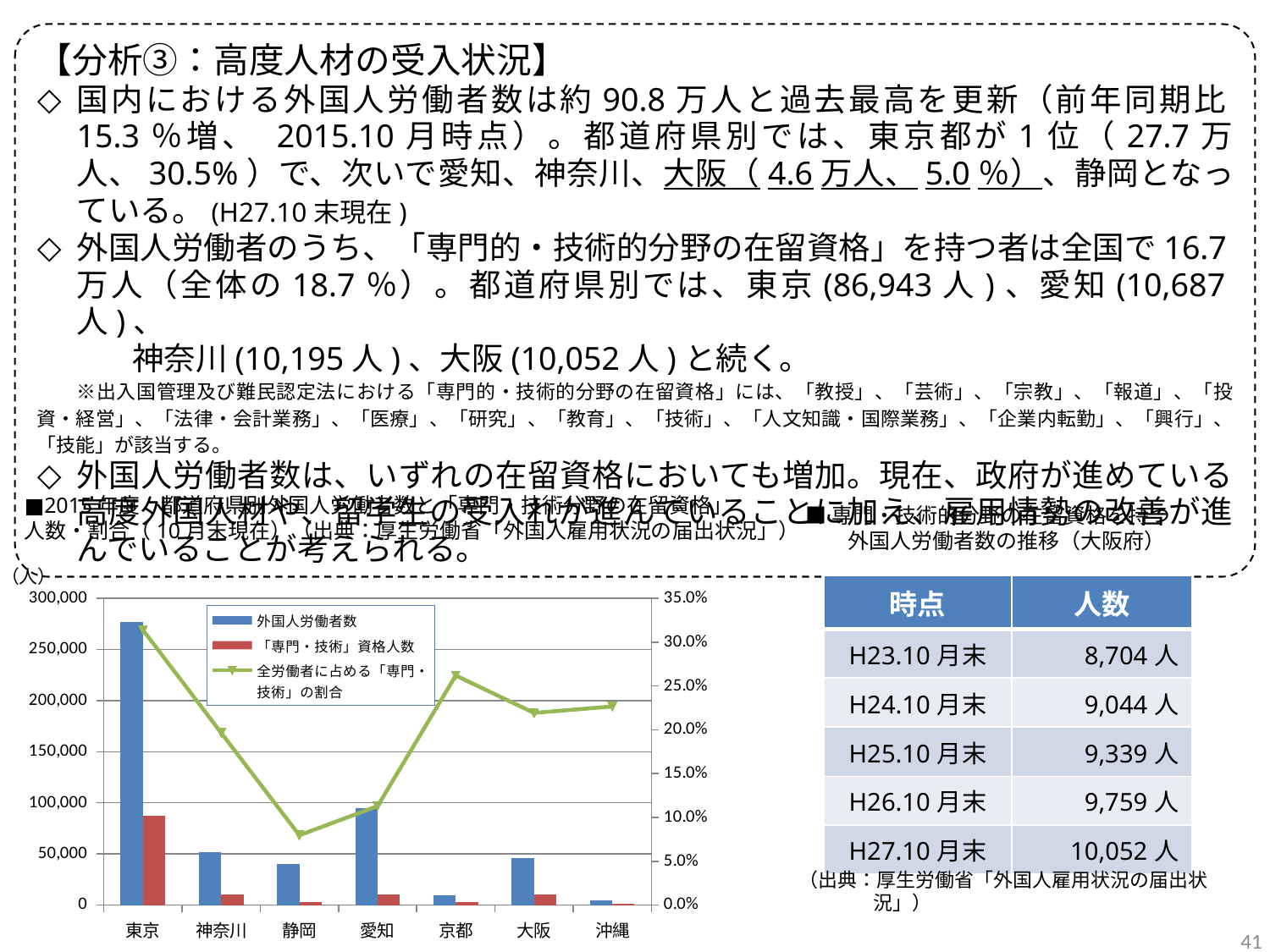
Is the value of 全労働者に占める「専門・技術」の割合 for 静岡 greater or less than 10.0%? less Which prefecture has the lowest value for 外国人労働者数 in the chart? 沖縄 Which series in the chart is drawn as a line rather than bars? 全労働者に占める「専門・技術」の割合 Which has the larger 外国人労働者数, 静岡 or 愛知? 愛知 Which prefecture has the lowest value for 全労働者に占める「専門・技術」の割合 in the chart? 静岡 What kind of chart is shown on the slide? Bar chart with a line series Is the value of 外国人労働者数 for 東京 greater or less than 250,000? greater How many series does the chart's legend list? 3 Which prefecture has the highest value for 全労働者に占める「専門・技術」の割合 in the chart? 東京 How many categories (prefectures) are shown on the x axis of the chart? 7 Is the value of 外国人労働者数 for 愛知 greater or less than 100,000? less Which prefecture has the highest value for 外国人労働者数 in the chart? 東京